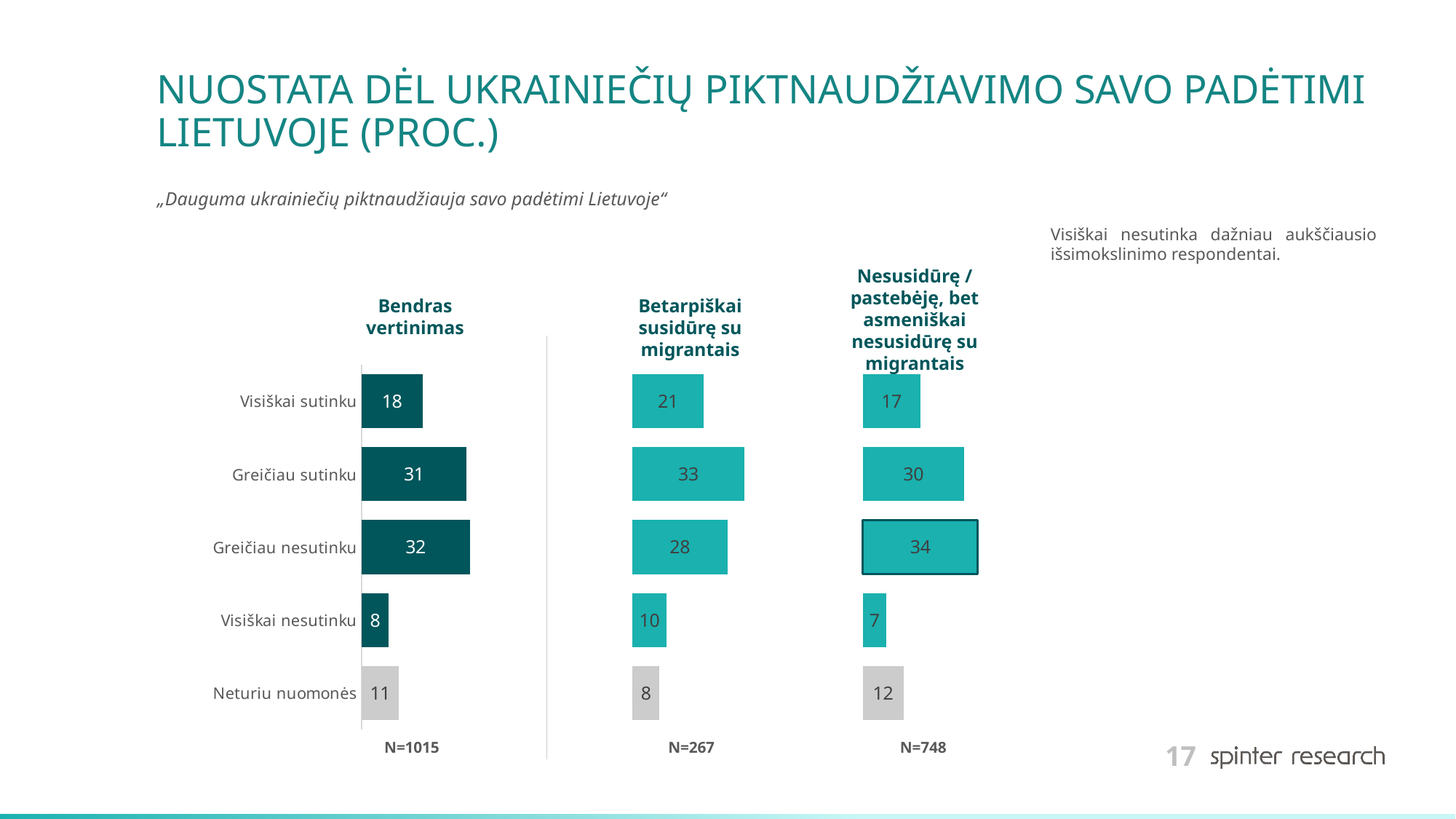
In the "Bendras vertinimas" chart, what is the value for "Greičiau nesutinku"? 32 Which is larger: "Visiškai sutinku" in the "Betarpiškai susidūrę su migrantais" chart or "Visiškai sutinku" in the "Nesusidūrę / pastebėję, bet asmeniškai nesusidūrę su migrantais" chart? Betarpiškai susidūrę su migrantais In the "Nesusidūrę / pastebėję, bet asmeniškai nesusidūrę su migrantais" chart, what is the value for "Neturiu nuomonės"? 12 In the "Betarpiškai susidūrę su migrantais" chart, what is the difference between "Visiškai nesutinku" and "Neturiu nuomonės"? 2 In the "Nesusidūrę / pastebėję, bet asmeniškai nesusidūrę su migrantais" chart, which category has the lowest value? Visiškai nesutinku What type of chart is the "Bendras vertinimas" chart? Bar chart How many categories does the "Bendras vertinimas" chart show? 5 In the "Nesusidūrę / pastebėję, bet asmeniškai nesusidūrę su migrantais" chart, what is the difference between "Greičiau nesutinku" and "Greičiau sutinku"? 4 In the "Betarpiškai susidūrę su migrantais" chart, which category has the highest value? Greičiau sutinku In the "Betarpiškai susidūrę su migrantais" chart, what is the value for "Visiškai sutinku"? 21 What sample size (N) is shown under the "Betarpiškai susidūrę su migrantais" chart? N=267 In the "Bendras vertinimas" chart, which category has the lowest value? Visiškai nesutinku